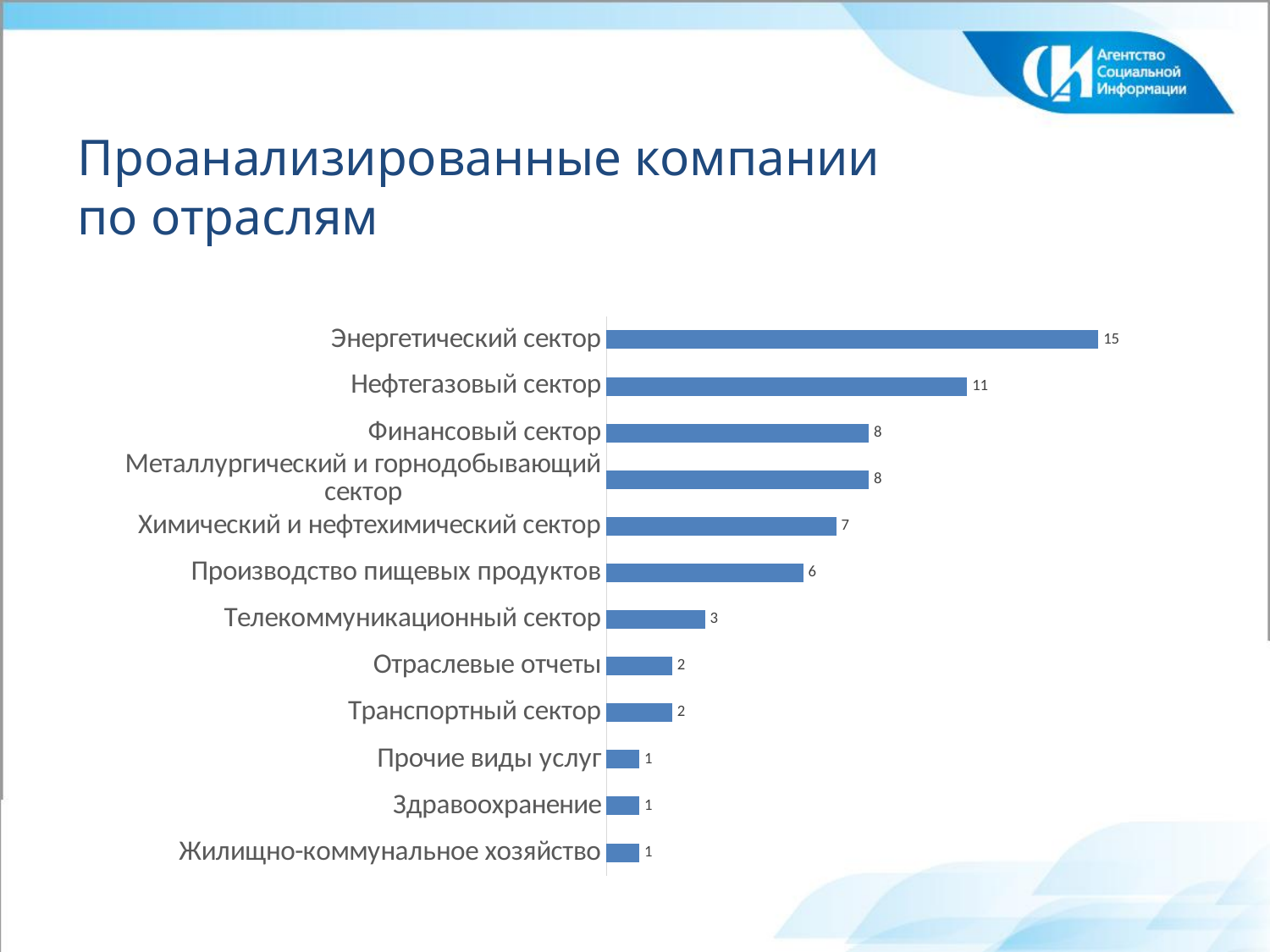
What is the title of the slide? Проанализированные компании по отраслям Which category has the highest value? Энергетический сектор What is the difference between Финансовый сектор and Химический и нефтехимический сектор? 1 Which is larger, Нефтегазовый сектор or Финансовый сектор? Нефтегазовый сектор Which is larger, Телекоммуникационный сектор or Транспортный сектор? Телекоммуникационный сектор What is the difference between Энергетический сектор and Нефтегазовый сектор? 4 What is the value for Производство пищевых продуктов? 6 How many categories are shown in the chart? 12 What is the value for Энергетический сектор? 15 What is the value for Нефтегазовый сектор? 11 What kind of chart is shown on the slide? Bar chart What is the value for Телекоммуникационный сектор? 3